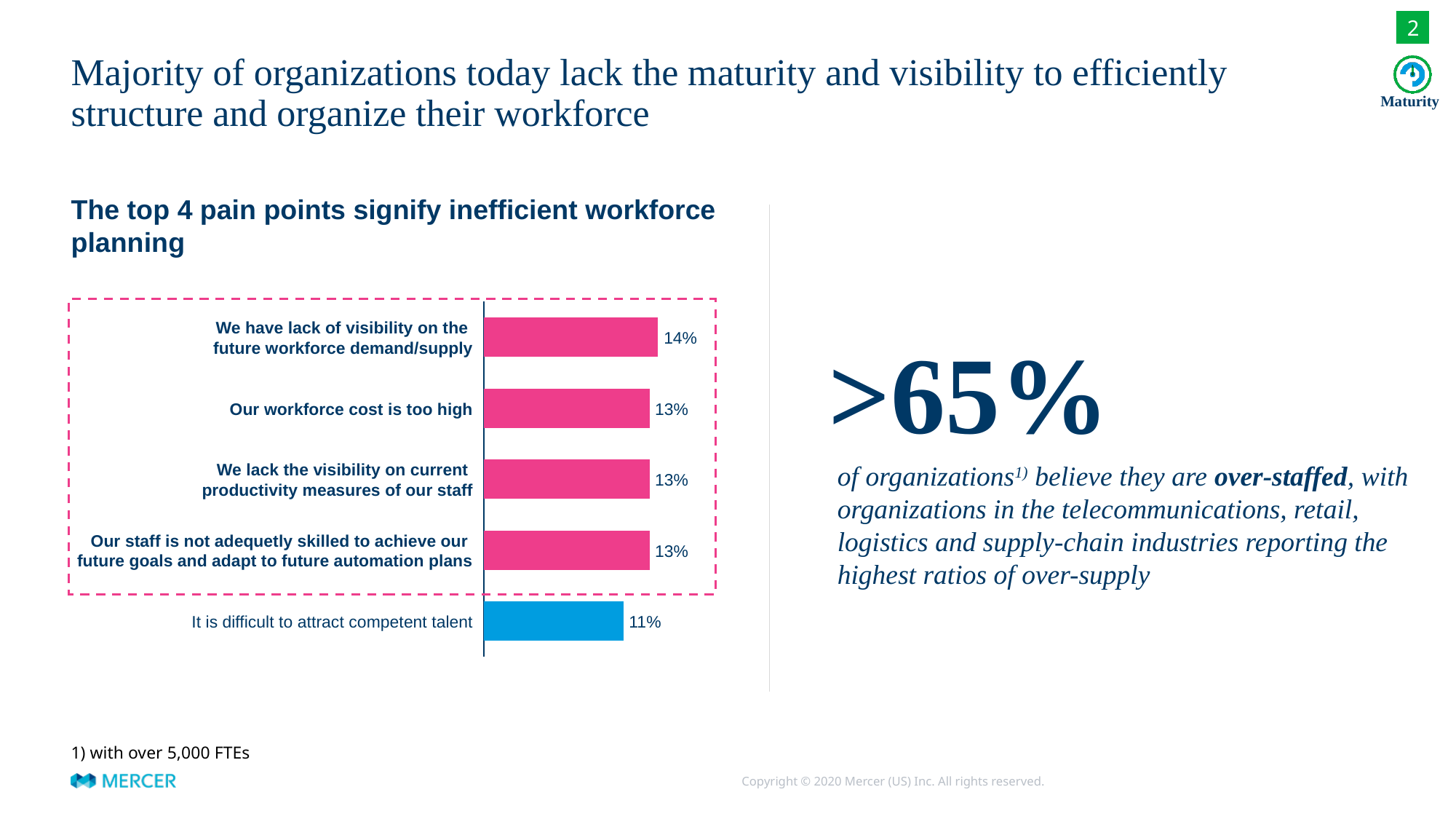
Which pain point has the lowest percentage? It is difficult to attract competent talent How many pain points (bars) are plotted in the chart? 5 Which pain point has the highest percentage? We have lack of visibility on the future workforce demand/supply Which is larger: the value for "Our workforce cost is too high" or the value for "It is difficult to attract competent talent"? Our workforce cost is too high What percentage is shown for "We have lack of visibility on the future workforce demand/supply"? 14% What percentage is shown for "It is difficult to attract competent talent"? 11% What value is shown for "Our staff is not adequetly skilled to achieve our future goals and adapt to future automation plans"? 13% What type of chart is used to show the pain points? Bar chart What is the difference between the highest bar (14%) and the lowest bar (11%)? 3% How many bars are enclosed in the dashed box highlighting the top pain points? 4 Which bar is shown in a different colour (blue) from the others? It is difficult to attract competent talent What value is shown for "Our workforce cost is too high"? 13%